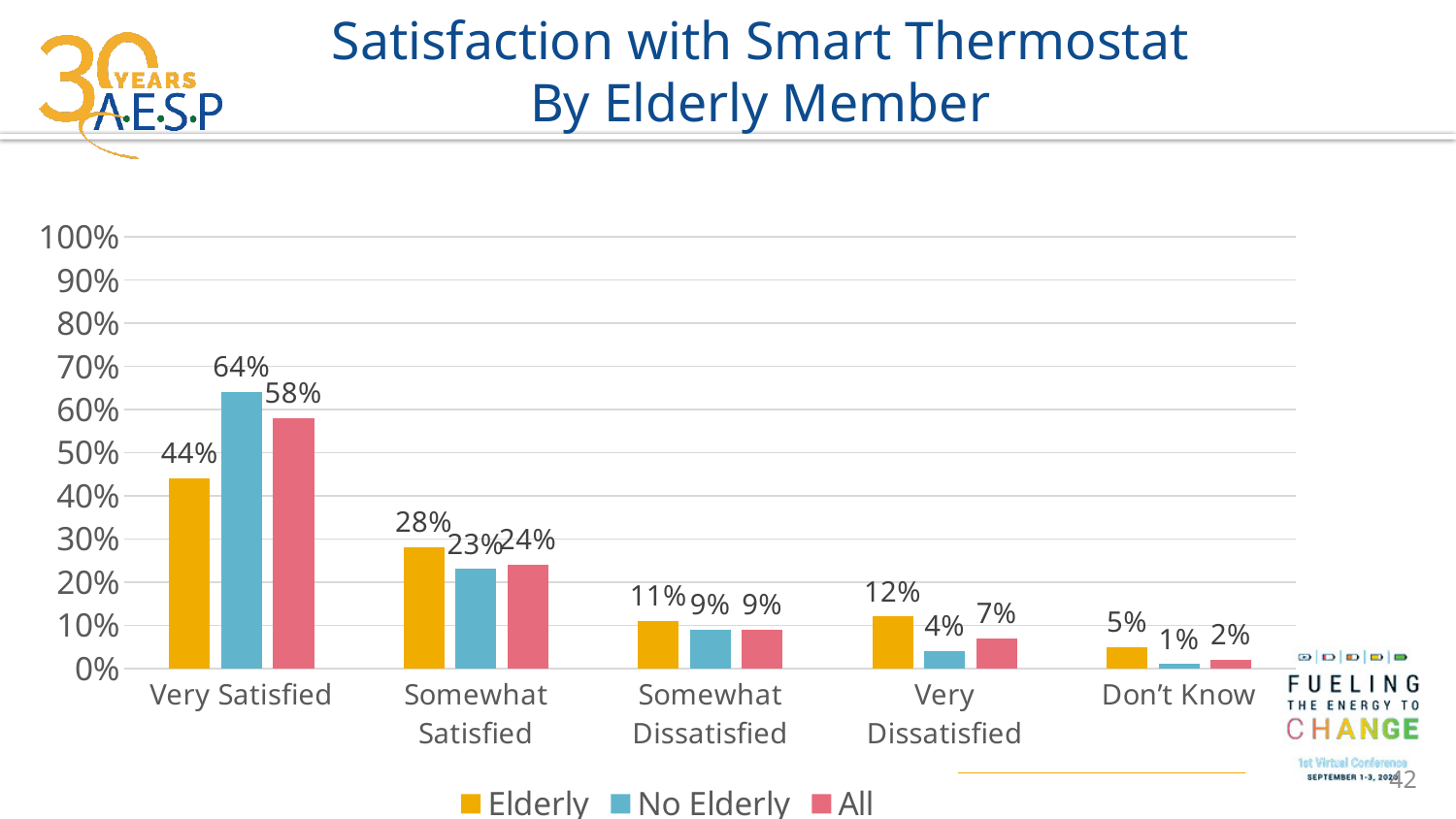
What is the value for No Elderly in the Very Satisfied category? 64% What is the difference between the No Elderly and Elderly values in the Very Satisfied category? 20% Which is larger in the Somewhat Satisfied category, Elderly or No Elderly? Elderly How many categories are shown on the x axis? 5 What is the value for Elderly in the Very Satisfied category? 44% What is the value for All in the Somewhat Satisfied category? 24% What kind of chart is shown on the slide? Bar chart How many series does the legend list? 3 Which category has the lowest value for the All series? Don't Know What is the value for Elderly in the Very Dissatisfied category? 12% Which category has the highest value for the No Elderly series? Very Satisfied What is the title of the chart? Satisfaction with Smart Thermostat By Elderly Member